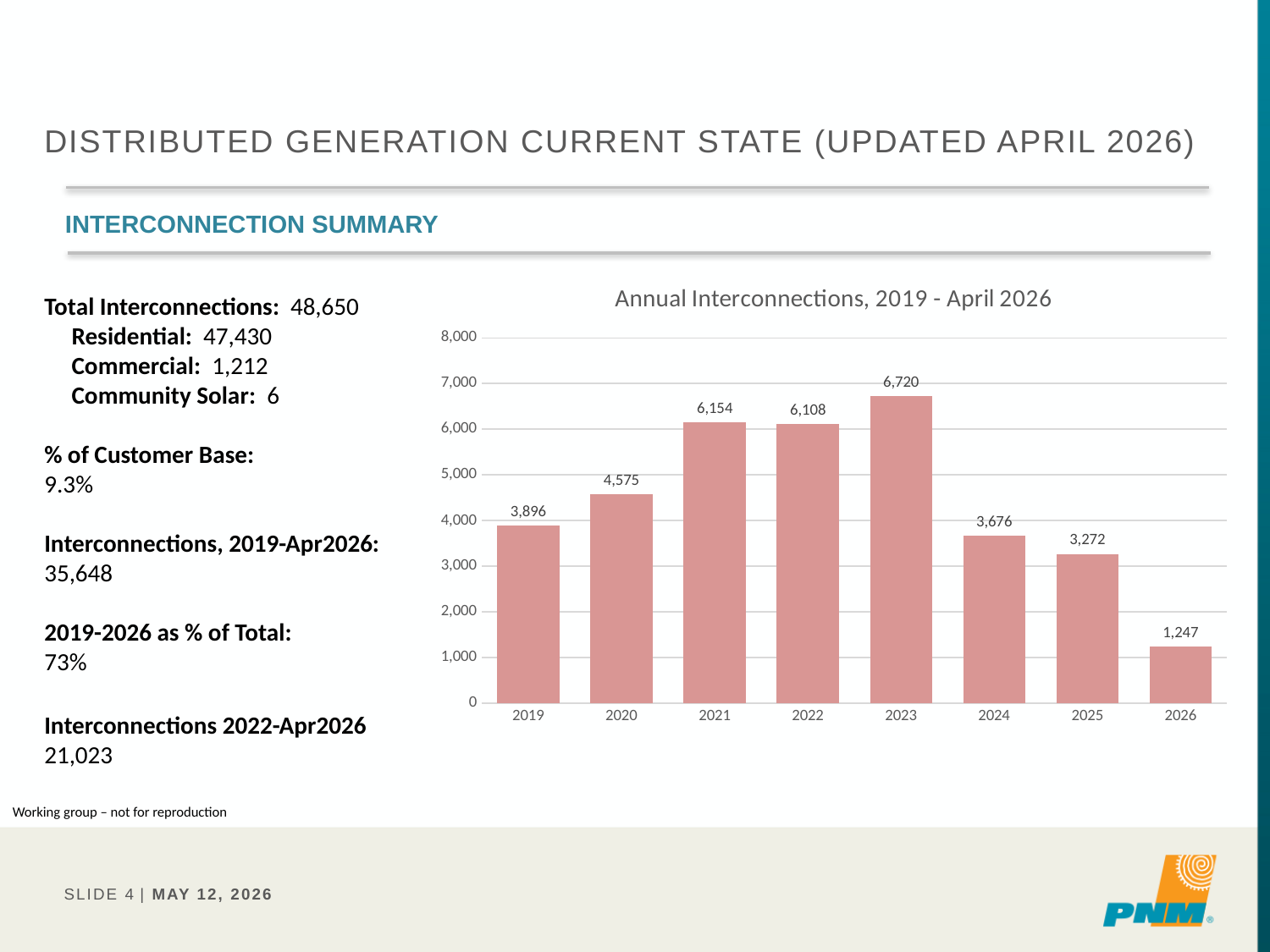
Which year has the highest value in the Annual Interconnections chart? 2023 Do the values in the Annual Interconnections chart rise or fall from 2023 to 2026? fall What is the value for 2019 in the Annual Interconnections chart? 3,896 What is the value for 2023 in the Annual Interconnections chart? 6,720 How many years are shown on the x axis of the Annual Interconnections chart? 8 What is the difference between the values for 2023 and 2024 in the Annual Interconnections chart? 3,044 Which year has the lowest value in the Annual Interconnections chart? 2026 Is the value for 2020 in the Annual Interconnections chart greater or less than 4,000? greater What kind of chart is the Annual Interconnections chart? bar chart Which is larger in the Annual Interconnections chart, the value for 2021 or the value for 2022? 2021 What is the value for 2026 in the Annual Interconnections chart? 1,247 What is the title of the chart on the slide? Annual Interconnections, 2019 - April 2026